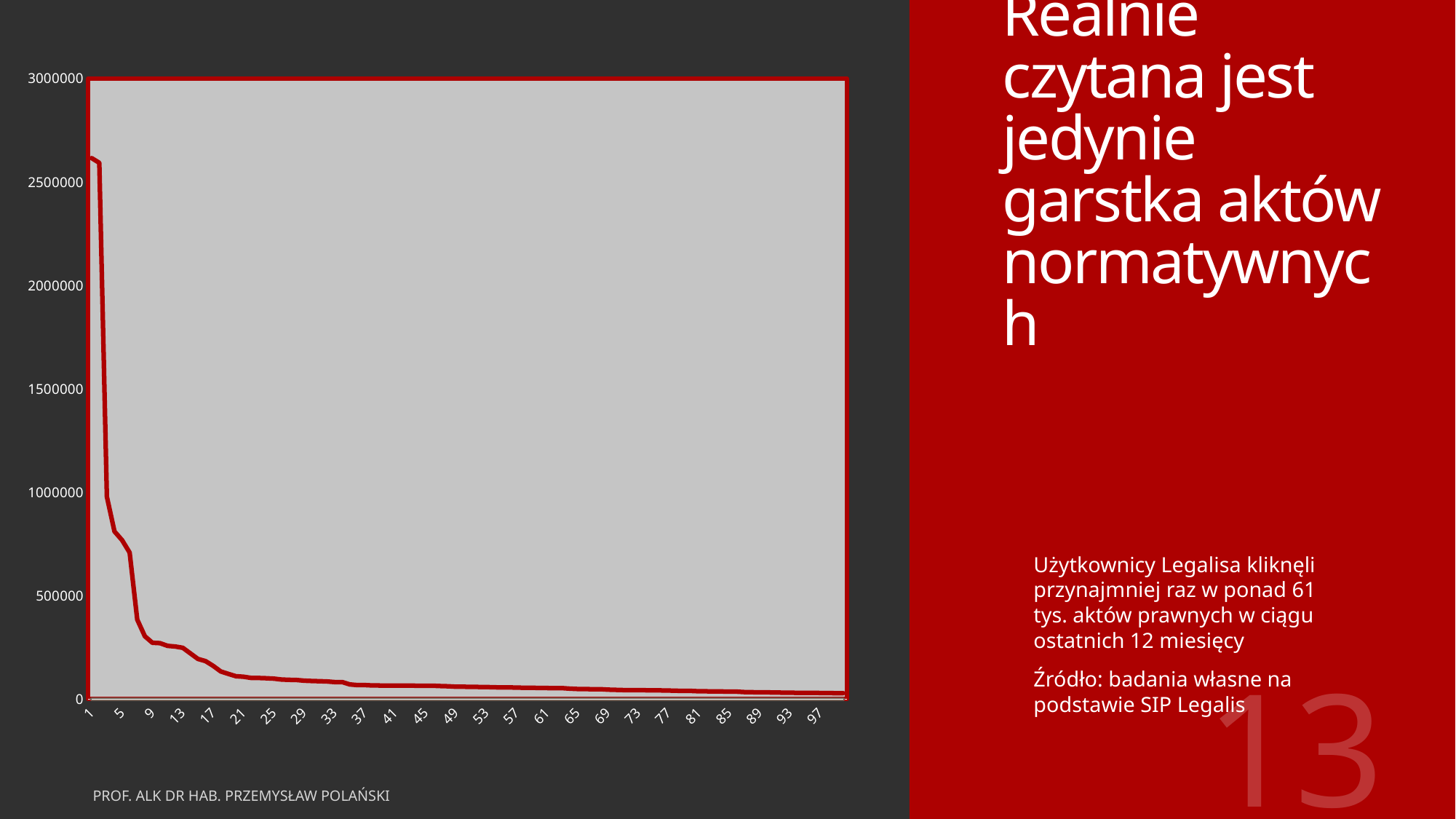
What is the last label shown on the x axis? 97 Is the value at x = 5 greater or less than 1000000? less Is the value at x = 9 greater or less than 500000? less At which x-axis position is the plotted value highest? 1 Which is larger, the value at x = 1 or the value at x = 97? x = 1 Is the value at x = 5 greater or less than 500000? greater Which is larger, the value at x = 5 or the value at x = 13? x = 5 What is the highest tick value shown on the y axis? 3000000 Do the values rise or fall as you move along the x axis from 1 to 97? fall What kind of chart is shown on the slide? line chart